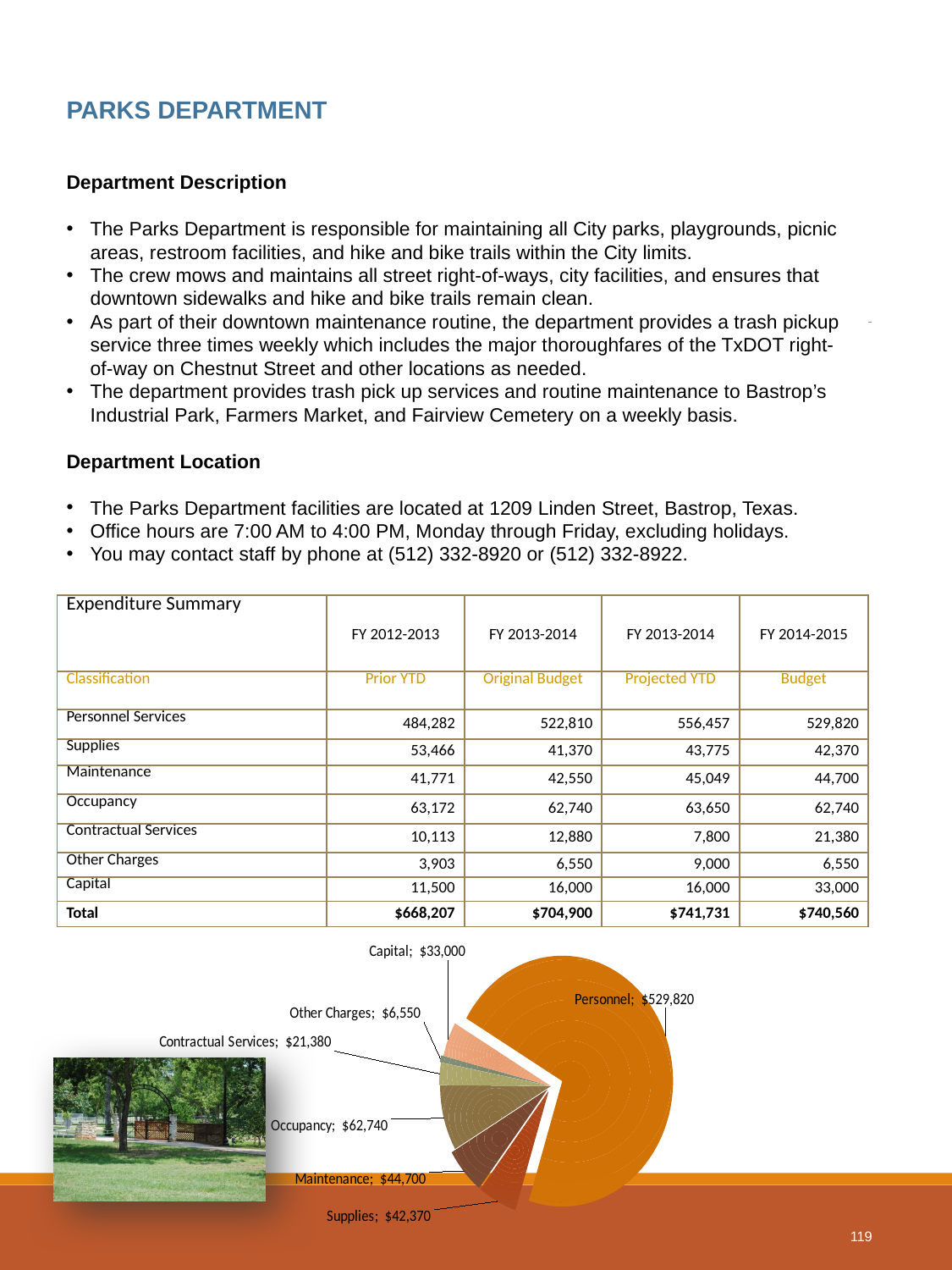
What type of chart is shown at the bottom of the slide? pie chart In the pie chart, what is the value for Personnel? $529,820 In the pie chart, what is the difference between Maintenance and Supplies? $2,330 In the pie chart, what is the value for Occupancy? $62,740 Which category has the largest slice in the pie chart? Personnel In the pie chart, what is the value for Capital? $33,000 In the pie chart, which is larger, Supplies or Contractual Services? Supplies In the pie chart, which is larger, Occupancy or Capital? Occupancy In the pie chart, what is the value for Contractual Services? $21,380 How many slices does the pie chart have? 7 In the pie chart, what is the difference between Personnel and Occupancy? $467,080 Which category has the smallest slice in the pie chart? Other Charges